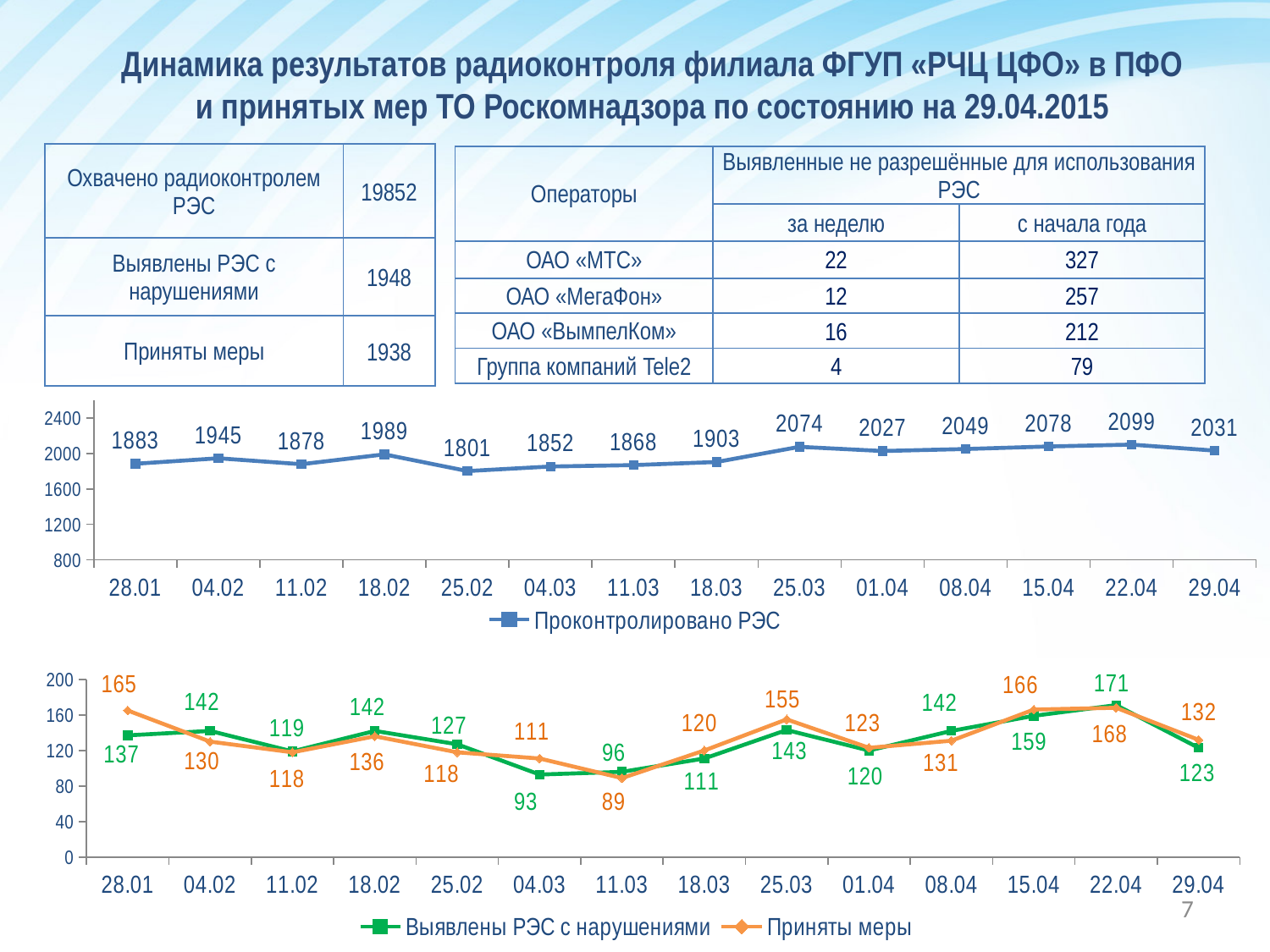
In the top chart (Проконтролировано РЭС), which date has the highest value? 22.04 In the bottom chart, how many series does the legend list? 2 In the bottom chart, which date has the lowest value for Приняты меры? 11.03 In the top chart (Проконтролировано РЭС), what is the value for 18.02? 1989 In the top chart (Проконтролировано РЭС), which date has the lowest value? 25.02 In the top chart (Проконтролировано РЭС), how many data points are plotted? 14 What type of chart is the top chart (Проконтролировано РЭС)? Line chart In the bottom chart, which date has the highest value for Выявлены РЭС с нарушениями? 22.04 In the bottom chart, which is larger on 25.03: Выявлены РЭС с нарушениями or Приняты меры? Приняты меры In the bottom chart, what is the value of Приняты меры for 28.01? 165 In the bottom chart, what is the value of Выявлены РЭС с нарушениями for 04.03? 93 In the top chart (Проконтролировано РЭС), what is the difference between the values for 29.04 and 28.01? 148